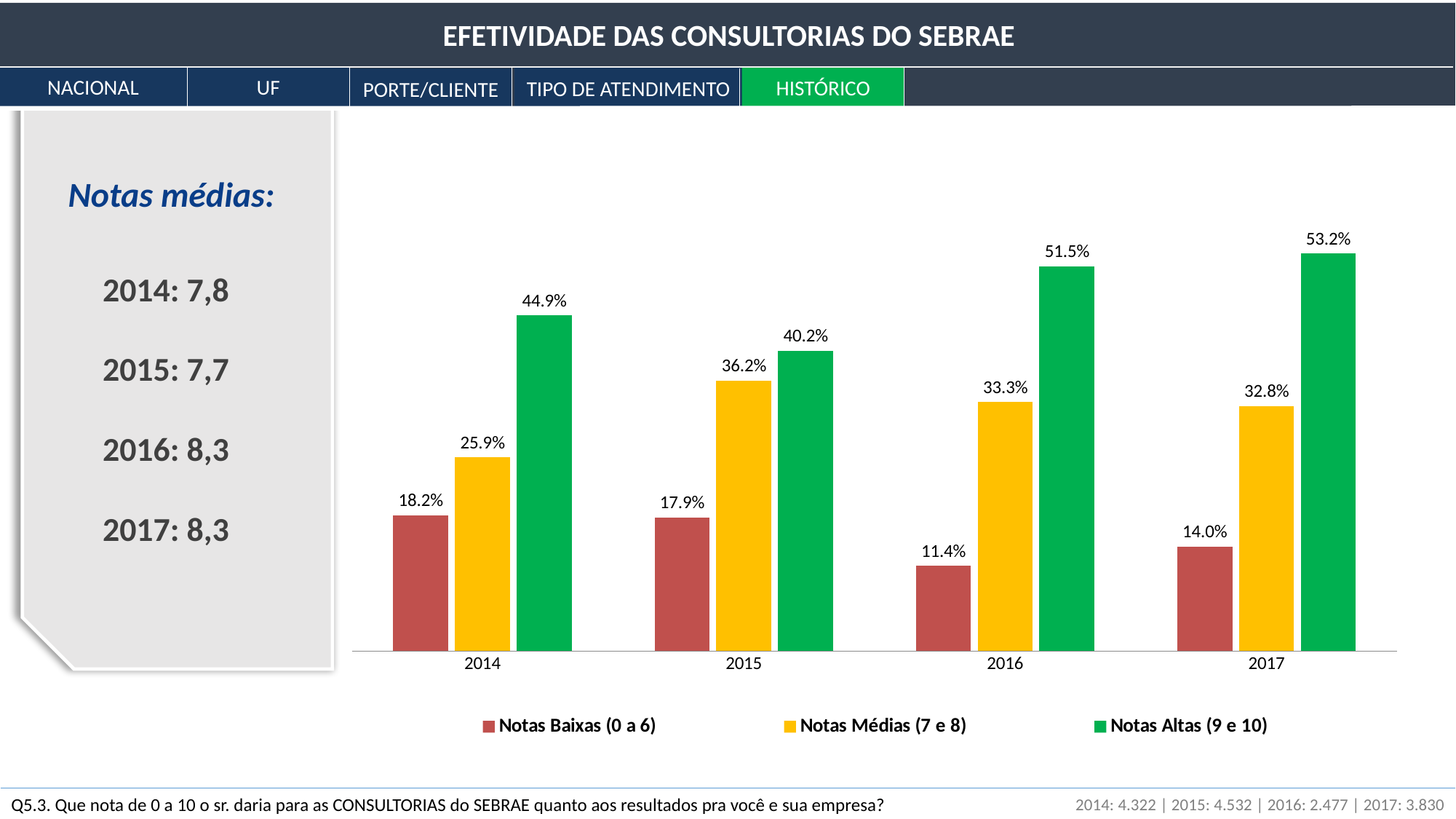
How many series does the legend list? 3 What colour represents Notas Baixas (0 a 6) in the chart? Red How many years are shown on the x axis? 4 What is the value for Notas Baixas (0 a 6) in 2016? 11.4% Which is larger: Notas Médias (7 e 8) in 2016 or Notas Médias (7 e 8) in 2017? 2016 In which year is the Notas Baixas (0 a 6) value lowest? 2016 Does the Notas Altas (9 e 10) series rise or fall from 2015 to 2017? Rise What is the value for Notas Altas (9 e 10) in 2017? 53.2% What kind of chart is shown on the slide? Bar chart What is the value for Notas Médias (7 e 8) in 2015? 36.2% In which year is the Notas Altas (9 e 10) value highest? 2017 What is the difference between the Notas Altas (9 e 10) values for 2017 and 2014? 8.3%